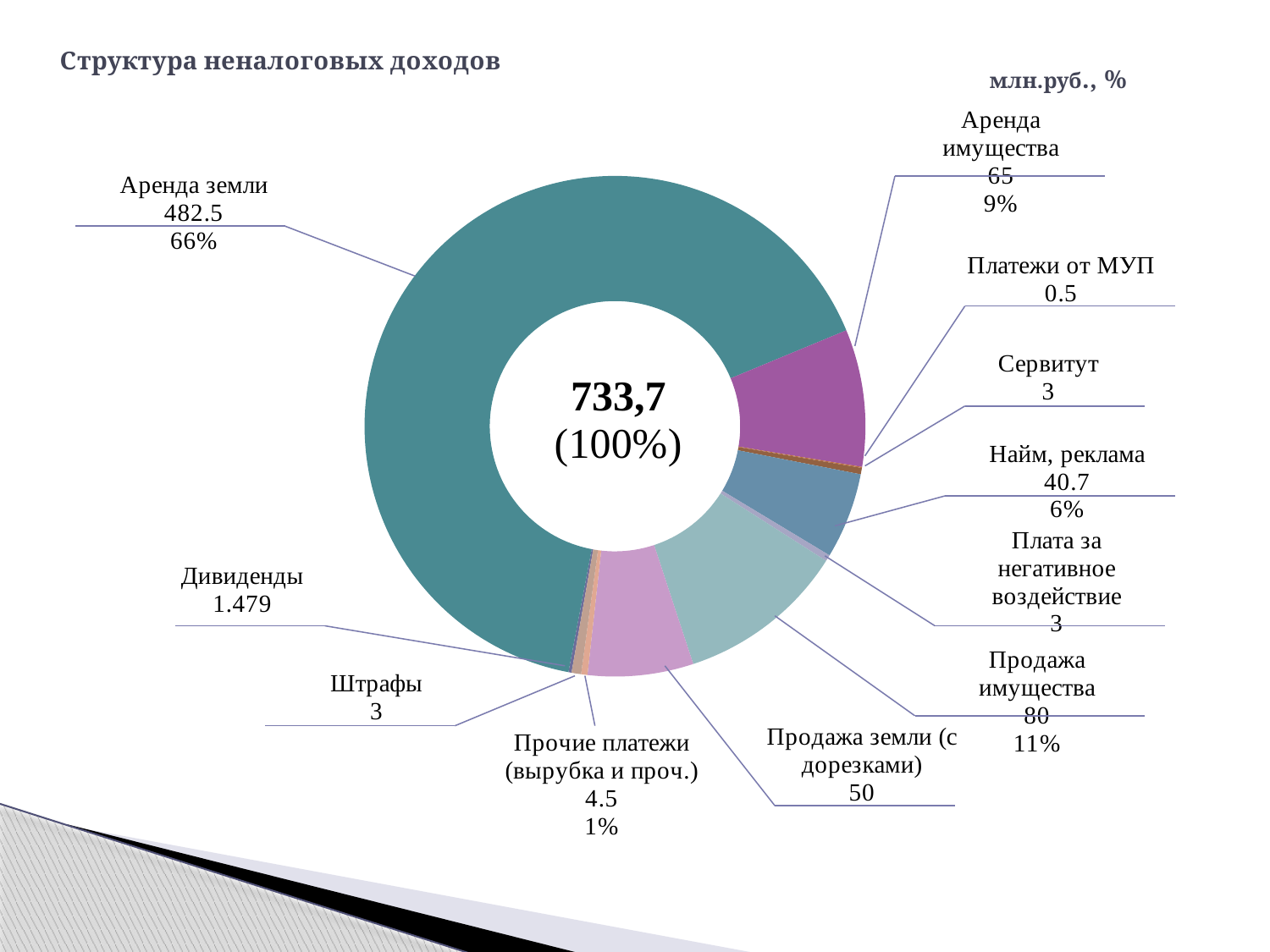
Which category has the highest value? Аренда земли What is the value for Платежи от МУП? 0.5 Which is larger, Аренда имущества or Найм, реклама? Аренда имущества What is the value for Дивиденды? 1.479 What is the value for Найм, реклама? 40.7 What is the value for Продажа имущества? 80 What is the value for Аренда земли? 482.5 What total value is shown in the centre of the chart? 733,7 How many categories are shown in the chart? 11 What share of the total does Аренда земли represent? 66% What is the difference between Продажа имущества and Продажа земли (с дорезками)? 30 Which category has the lowest value? Платежи от МУП